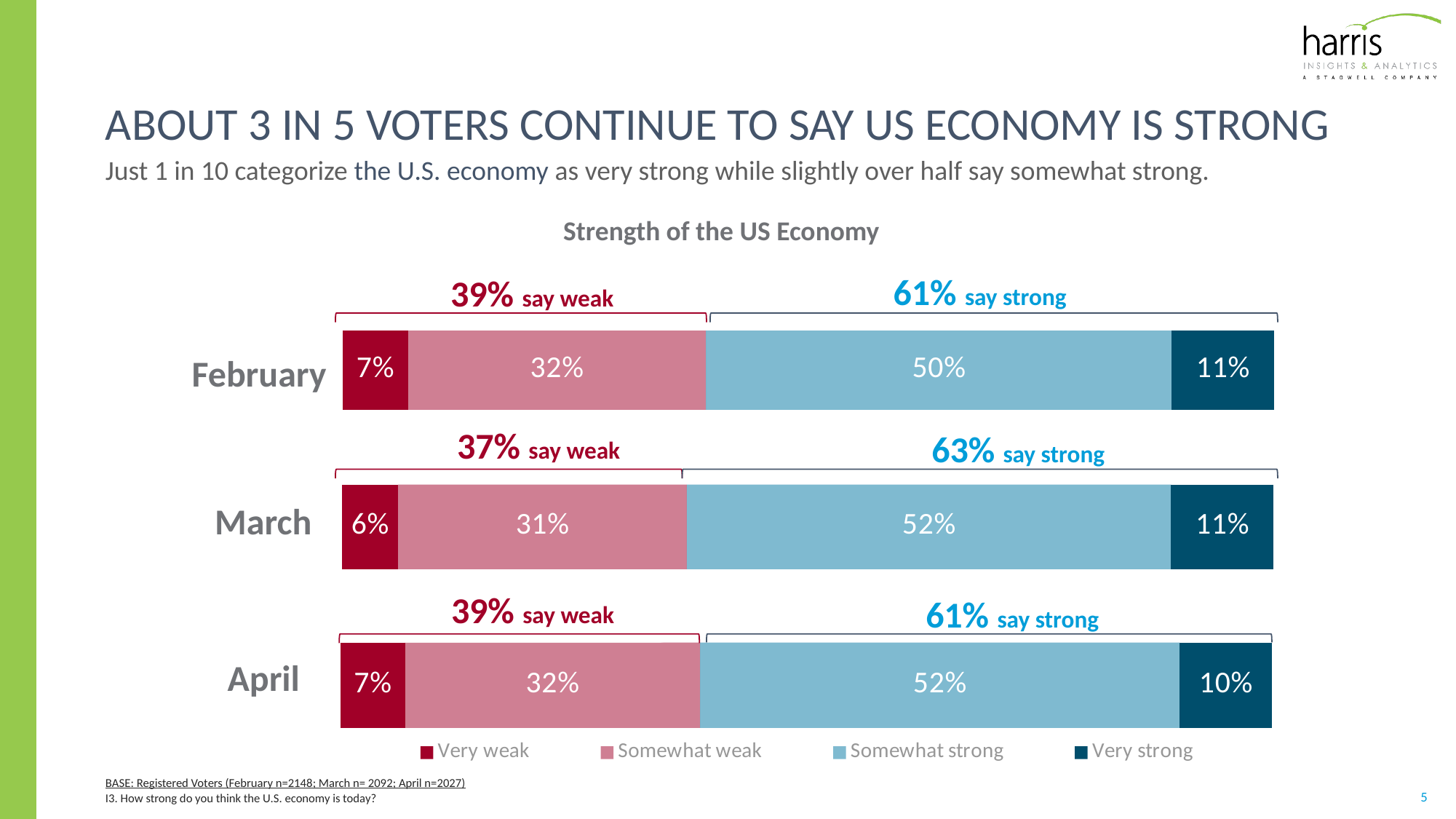
What is the difference between the 'Somewhat strong' share in April and in February? 2 percentage points What percentage of voters said the US economy was 'Very strong' in April? 10% What percentage of voters said the US economy was 'Somewhat strong' in February? 50% How many series does the legend list? 4 Which legend entry is shown in the darkest blue colour? Very strong What is the title of the chart? Strength of the US Economy What percentage of voters said the US economy was 'Very weak' in March? 6% How many months are shown in the chart? 3 What is the combined share of voters who said the economy was weak in March? 37% What kind of chart is shown on the slide? Stacked bar chart In which month was the 'Somewhat weak' share lowest? March Which is larger: the 'Very weak' share in February or in March? February